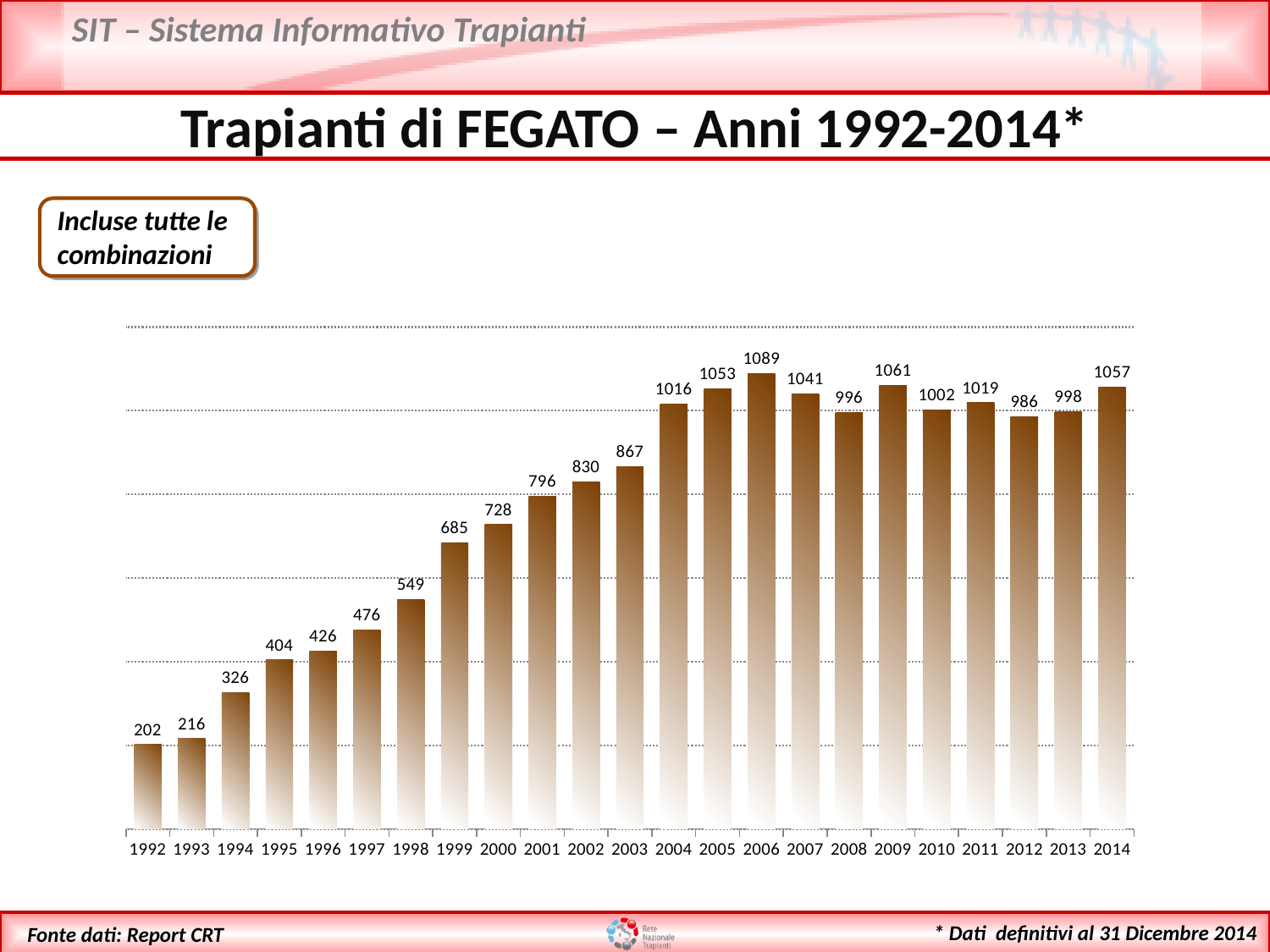
How many years are shown on the x axis? 23 What value is shown for 2006? 1089 What value is shown for 2014? 1057 What is the difference between the values for 2014 and 1992? 855 Which year has a larger value, 2009 or 2010? 2009 What was the number of liver transplants in 1992? 202 What is the title of the slide containing the chart? Trapianti di FEGATO – Anni 1992-2014* Which year has the lowest value? 1992 Do the values generally rise or fall from 1992 to 2006? rise What is the difference between the values for 2006 and 2005? 36 Which year has the highest value? 2006 What kind of chart is this? bar chart